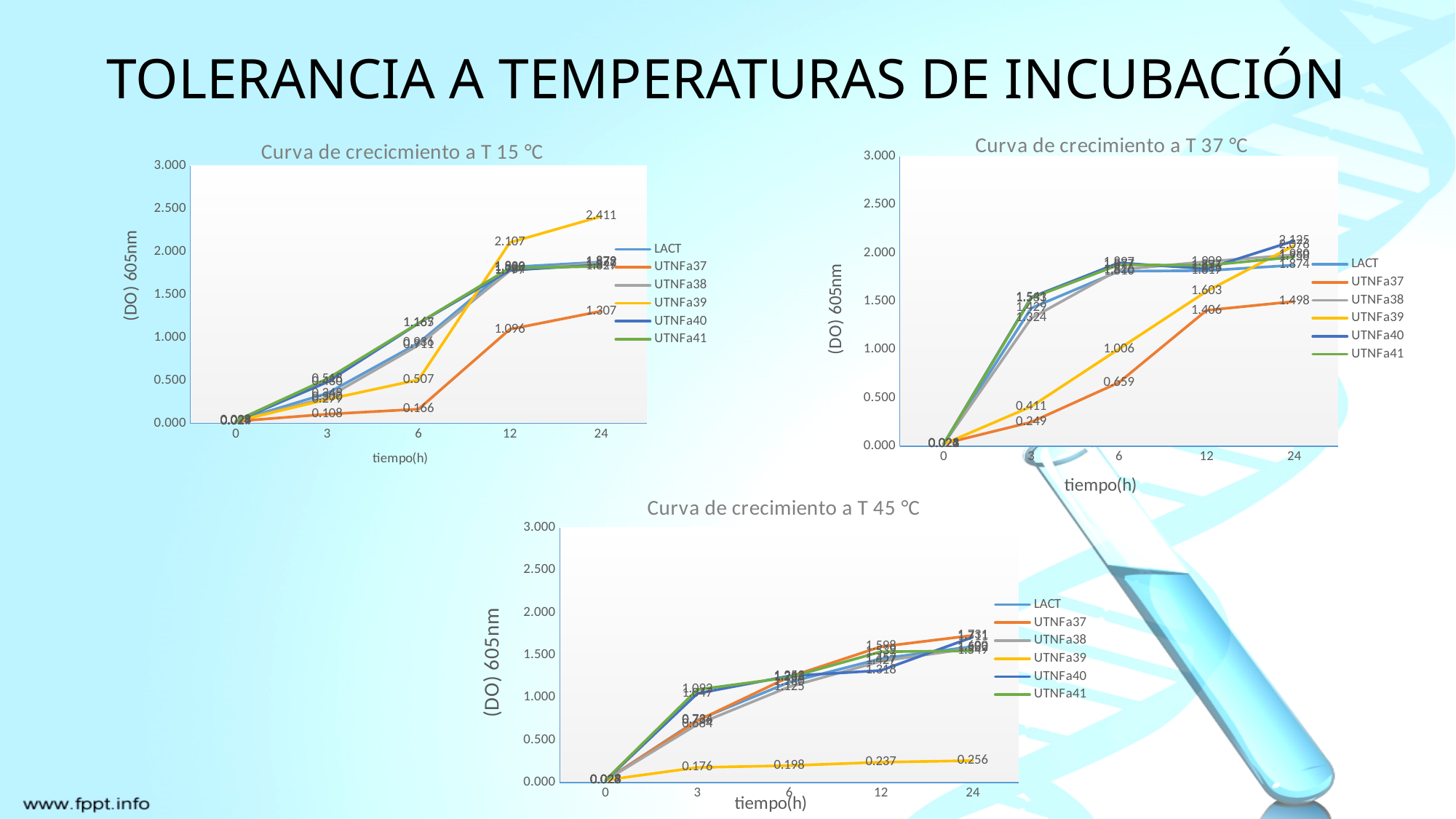
In "Curva de crecicmiento a T 15 °C", what is the value of UTNFa37 at 24 h? 1.307 How many series does the legend of "Curva de crecimiento a T 37 °C" list? 6 In "Curva de crecimiento a T 37 °C", what is the value of UTNFa37 at 24 h? 1.498 In "Curva de crecicmiento a T 15 °C", what is the difference between UTNFa39 and UTNFa37 at 24 h? 1.104 In "Curva de crecimiento a T 45 °C", what is the value of UTNFa39 at 24 h? 0.256 In "Curva de crecimiento a T 45 °C", is the value of UTNFa39 at 24 h greater or less than 0.500? less In "Curva de crecimiento a T 45 °C", does the UTNFa39 series rise or fall from 3 h to 24 h? rise How many time points are plotted on the x axis of "Curva de crecimiento a T 45 °C"? 5 What kind of chart is "Curva de crecicmiento a T 15 °C"? line chart In "Curva de crecicmiento a T 15 °C", which series has the lowest value at 24 h? UTNFa37 In "Curva de crecicmiento a T 15 °C", what is the value of UTNFa39 at 24 h? 2.411 In "Curva de crecicmiento a T 15 °C", which series has the highest value at 24 h? UTNFa39